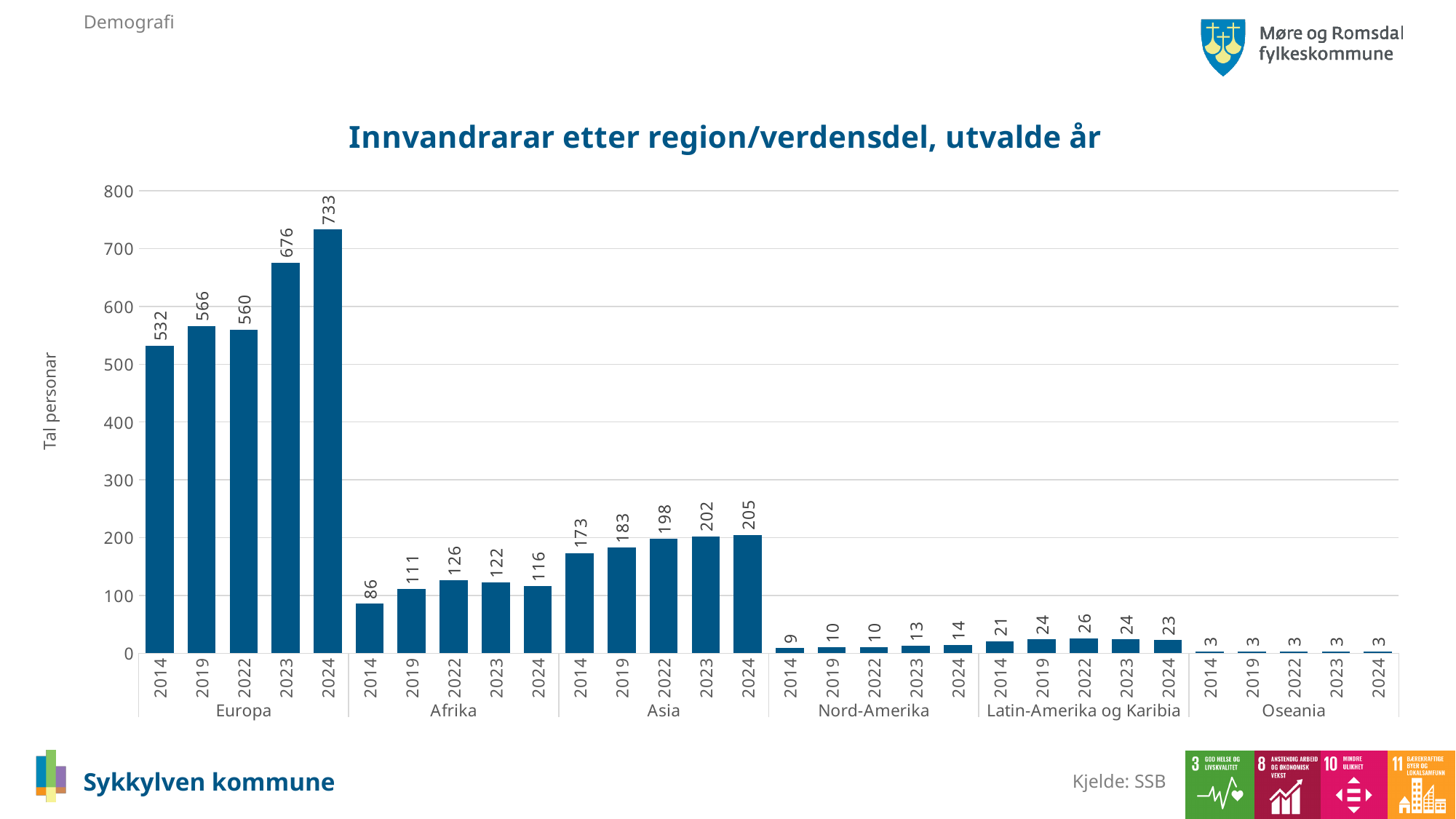
Do the values for Asia rise or fall from 2014 to 2024? Rise Which is larger: Afrika in 2022 or Afrika in 2024? Afrika in 2022 What is the value for Europa in 2024? 733 How many regions are shown on the x axis? 6 Is the value for Europa in 2023 greater or less than 600? greater What is the value for Nord-Amerika in 2023? 13 Which region has the lowest values across all years? Oseania What kind of chart is this? Bar chart What is the difference between the Europa values for 2024 and 2014? 201 What is the value for Afrika in 2014? 86 What is the value for Asia in 2022? 198 Which region has the highest bar in 2024? Europa